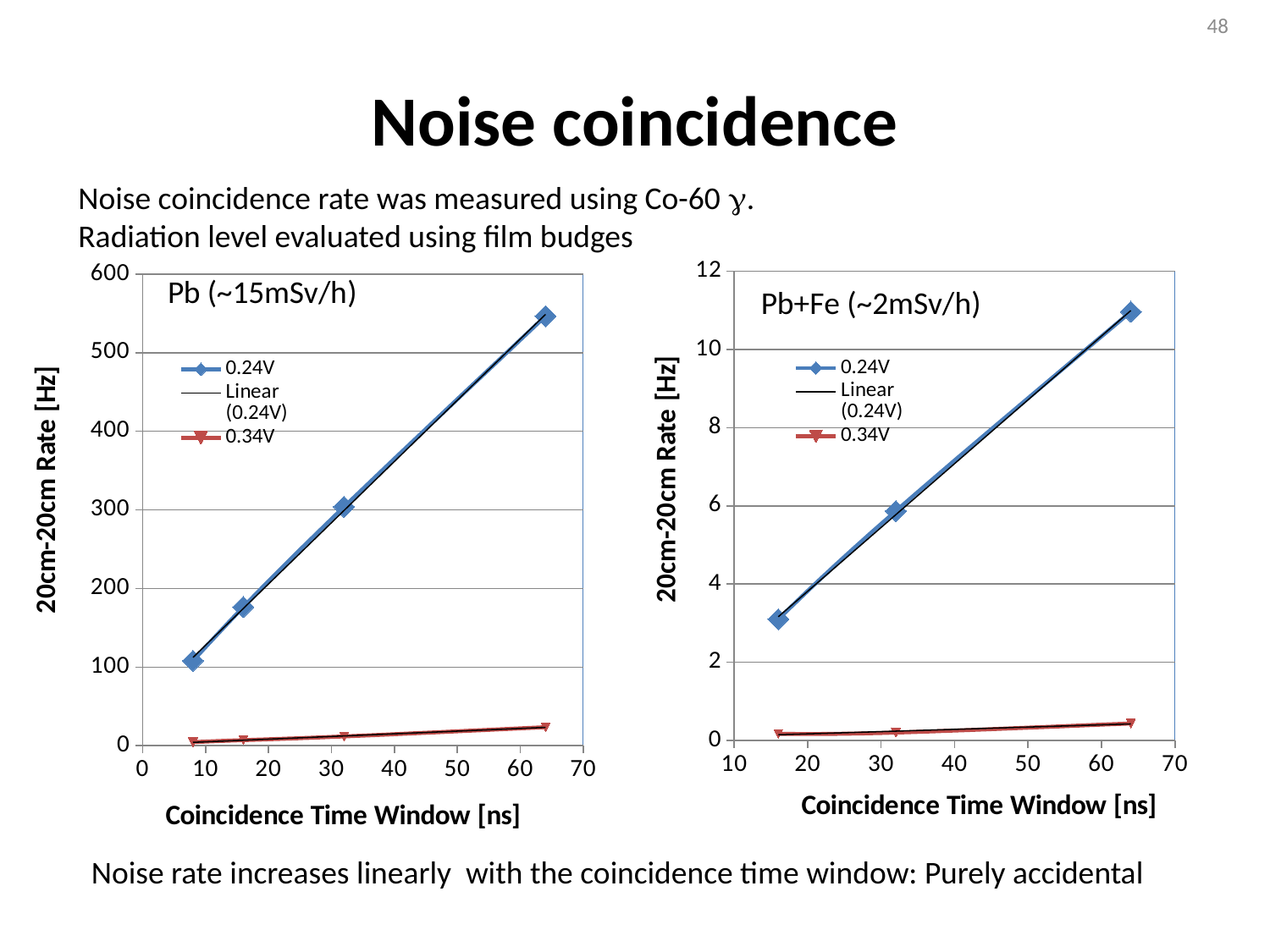
In the right chart (Pb+Fe ~2mSv/h), how many data points are plotted for the 0.24V series? 3 In the left chart (Pb ~15mSv/h), is the 0.24V value at a coincidence time window of 32 ns greater or less than 400? less In the right chart (Pb+Fe ~2mSv/h), is the 0.24V value at a coincidence time window of 16 ns greater or less than 4? less In the left chart (Pb ~15mSv/h), what kind of chart is used to show the data? Line chart In the left chart (Pb ~15mSv/h), how many series does the legend list? 3 What is the x-axis label of the left chart (Pb ~15mSv/h)? Coincidence Time Window [ns] In the right chart (Pb+Fe ~2mSv/h), is the 0.24V value at a coincidence time window of 64 ns greater or less than 10? greater In the right chart (Pb+Fe ~2mSv/h), how many series does the legend list? 3 In the right chart (Pb+Fe ~2mSv/h), which series has the higher values, 0.24V or 0.34V? 0.24V In the left chart (Pb ~15mSv/h), does the 0.24V noise rate rise or fall as the coincidence time window increases? rise In the left chart (Pb ~15mSv/h), how many data points are plotted for the 0.24V series? 4